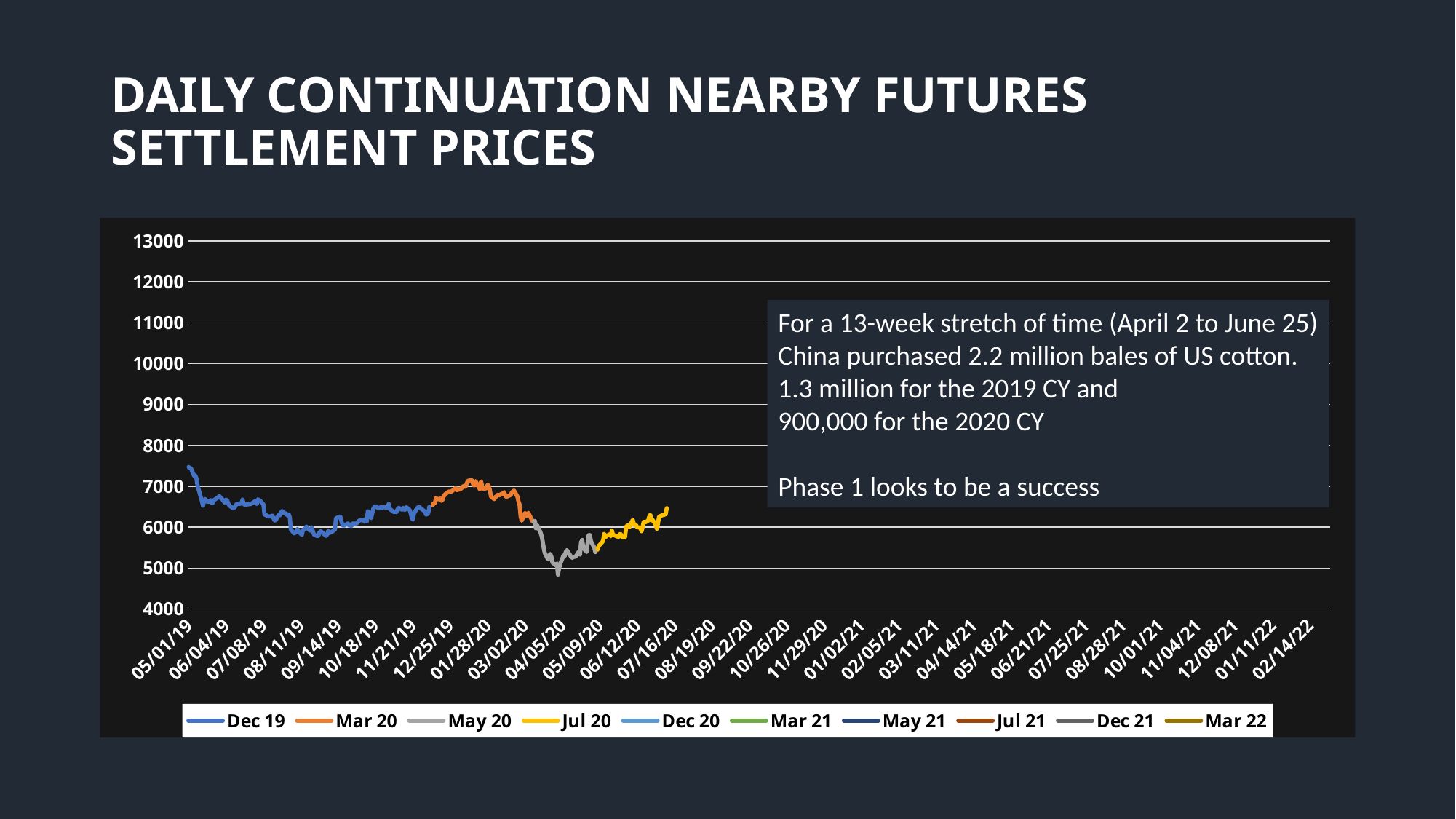
Is the lowest value of the May 20 series greater or less than 6000? less Is the first value of the Dec 19 series (at 05/01/19) greater or less than 7000? greater Which series reaches the highest point on the chart? Dec 19 Which series reaches the lowest point on the chart? May 20 Is the last value of the Jul 20 series greater or less than 7000? less What kind of chart is shown on the slide? line chart What colour is the Mar 20 series in the legend? orange How many series does the legend list? 10 Does the May 20 series generally rise or fall from its start to its end? fall What is the title of the chart on the slide? DAILY CONTINUATION NEARBY FUTURES SETTLEMENT PRICES Does the Jul 20 series generally rise or fall along the x axis? rise